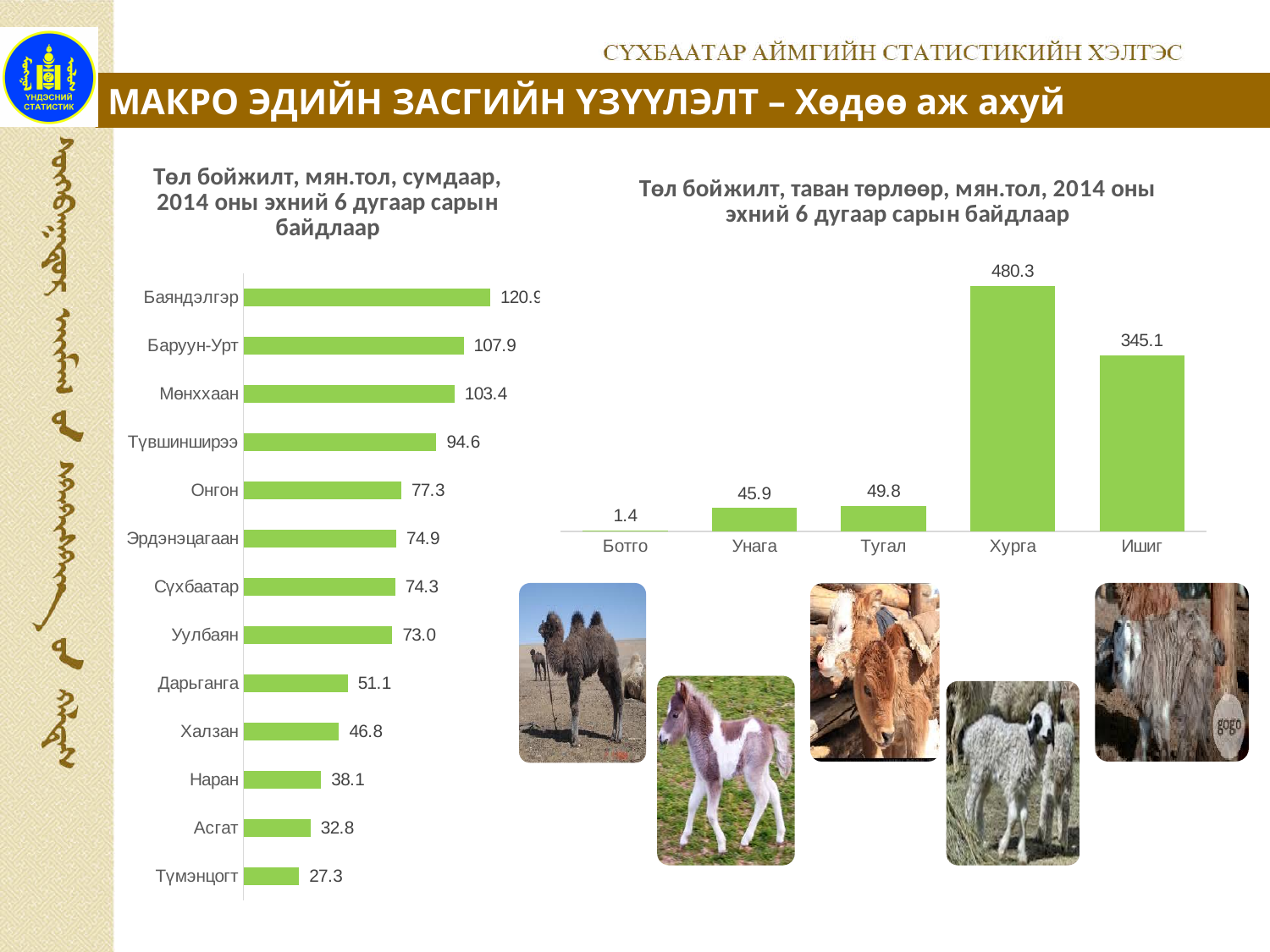
What type of chart is the right chart (Төл бойжилт, таван төрлөөр)? Bar chart In the right chart (Төл бойжилт, таван төрлөөр), what is the value for Ботго? 1.4 In the left chart (Төл бойжилт, мян.тол, сумдаар), what is the difference between Мөнххаан and Түвшинширээ? 8.8 In the right chart (Төл бойжилт, таван төрлөөр), what is the value for Хурга? 480.3 In the left chart (Төл бойжилт, мян.тол, сумдаар), how many categories are shown? 13 In the right chart (Төл бойжилт, таван төрлөөр), what is the difference between Хурга and Ишиг? 135.2 In the right chart (Төл бойжилт, таван төрлөөр), how many categories are shown? 5 In the right chart (Төл бойжилт, таван төрлөөр), which category has the highest value? Хурга In the left chart (Төл бойжилт, мян.тол, сумдаар), what is the value for Баруун-Урт? 107.9 In the left chart (Төл бойжилт, мян.тол, сумдаар), which is larger, Халзан or Наран? Халзан In the left chart (Төл бойжилт, мян.тол, сумдаар), which category has the lowest value? Түмэнцогт In the left chart (Төл бойжилт, мян.тол, сумдаар), what is the value for Дарьганга? 51.1